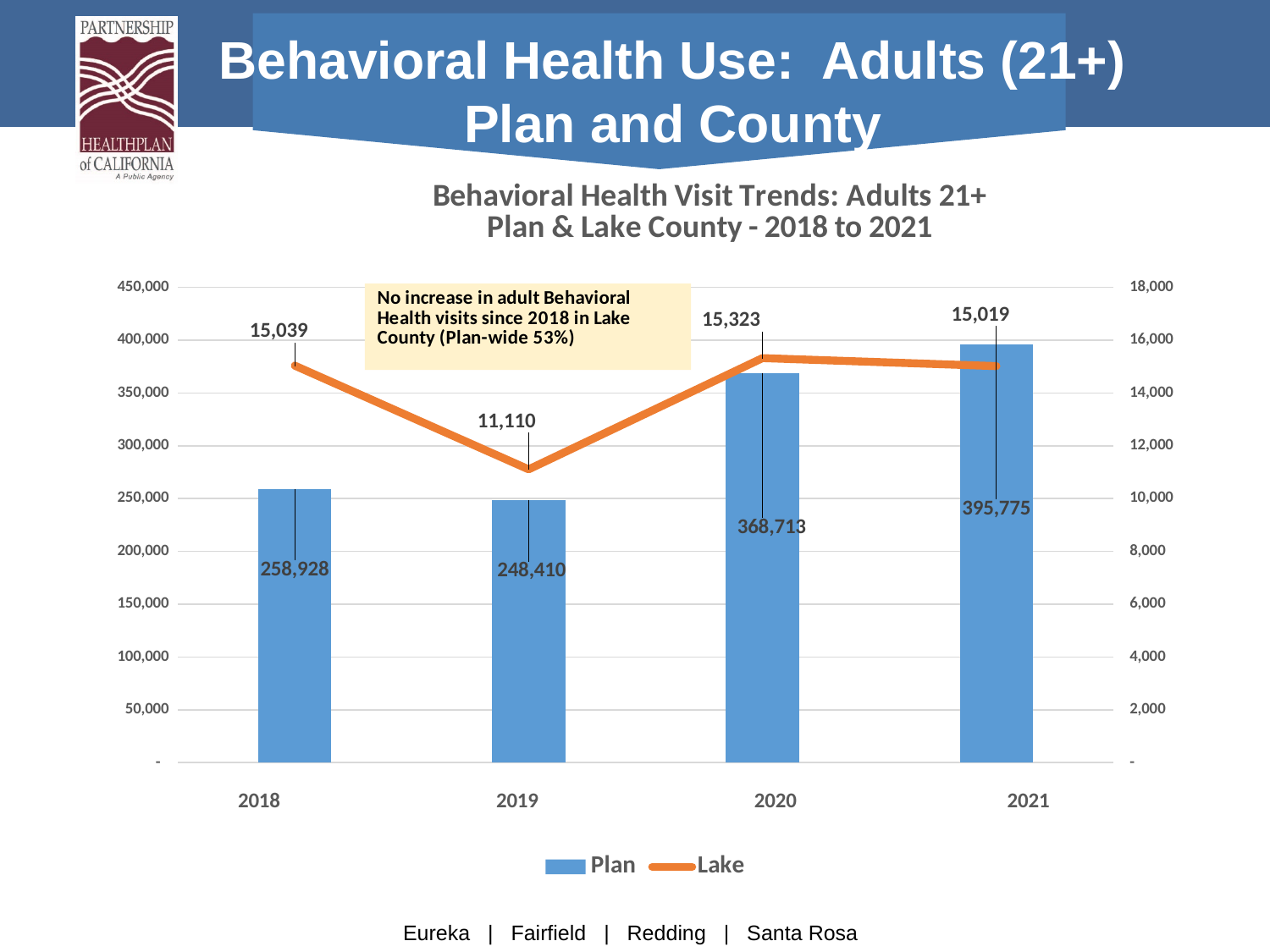
How many years are shown on the x axis? 4 What is the Plan value for 2021? 395,775 What is the difference between the Plan values for 2021 and 2018? 136,847 What is the difference between the Lake values for 2020 and 2019? 4,213 How many series does the legend list? 2 What is the title of the chart? Behavioral Health Visit Trends: Adults 21+ Plan & Lake County - 2018 to 2021 Which is larger, the Plan value for 2019 or the Plan value for 2020? 2020 What is the Lake value for 2020? 15,323 Which year has the lowest Lake value? 2019 What is the Plan value for 2018? 258,928 What is the Lake value for 2019? 11,110 Which year has the highest Plan value? 2021